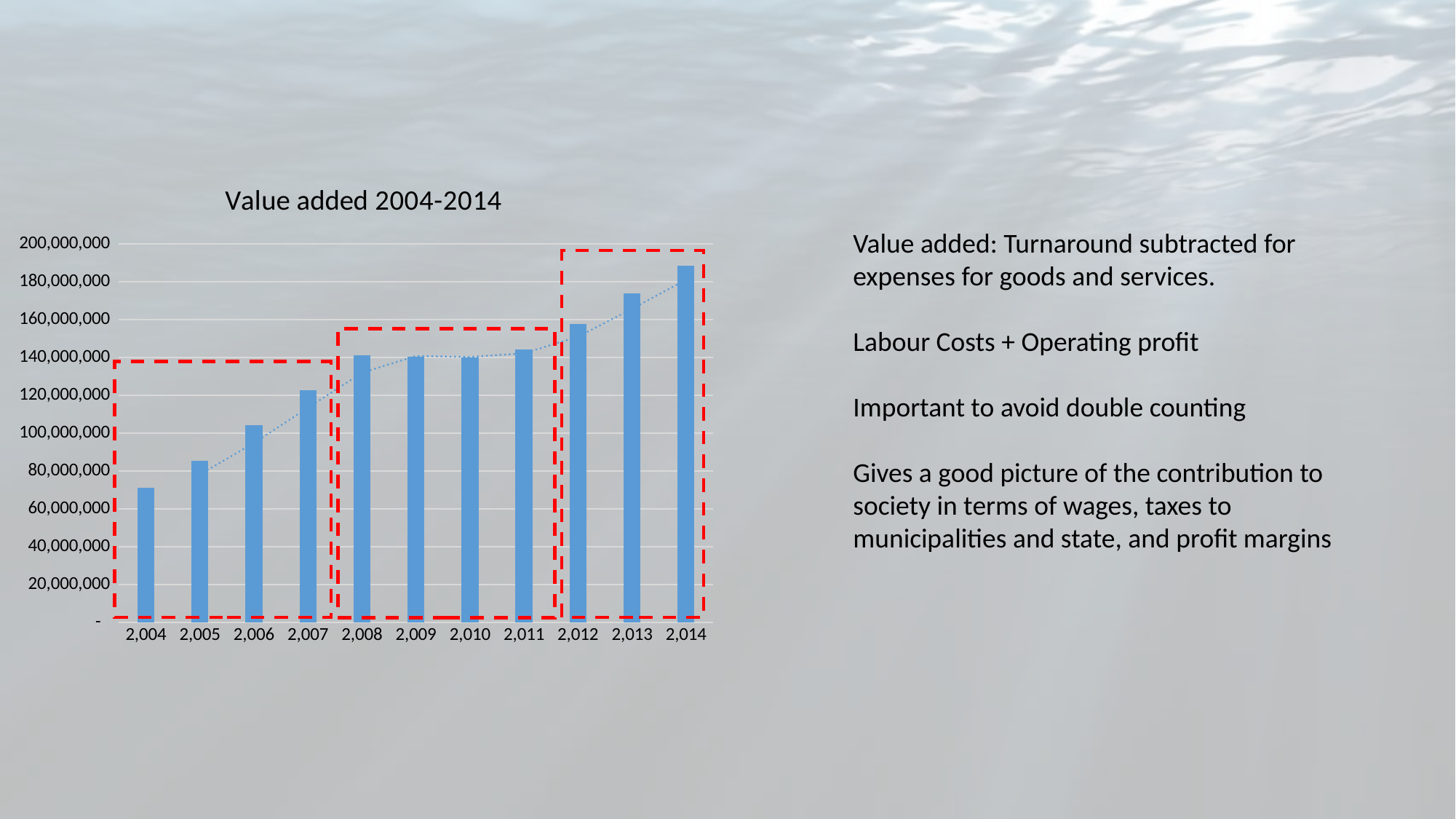
Is the value for 2014 greater or less than 180,000,000? greater Is the value for 2004 greater or less than 80,000,000? less Do the values generally rise or fall from 2004 to 2014? Rise Which year has the highest value added? 2014 What kind of chart is shown on the slide? Bar chart Is the value for 2012 greater or less than 160,000,000? less Which year has the lowest value added? 2004 How many years are plotted on the x axis of the chart? 11 How many red dashed boxes group the bars on the chart? 3 What is the title of the chart? Value added 2004-2014 Which year has the larger value, 2007 or 2012? 2012